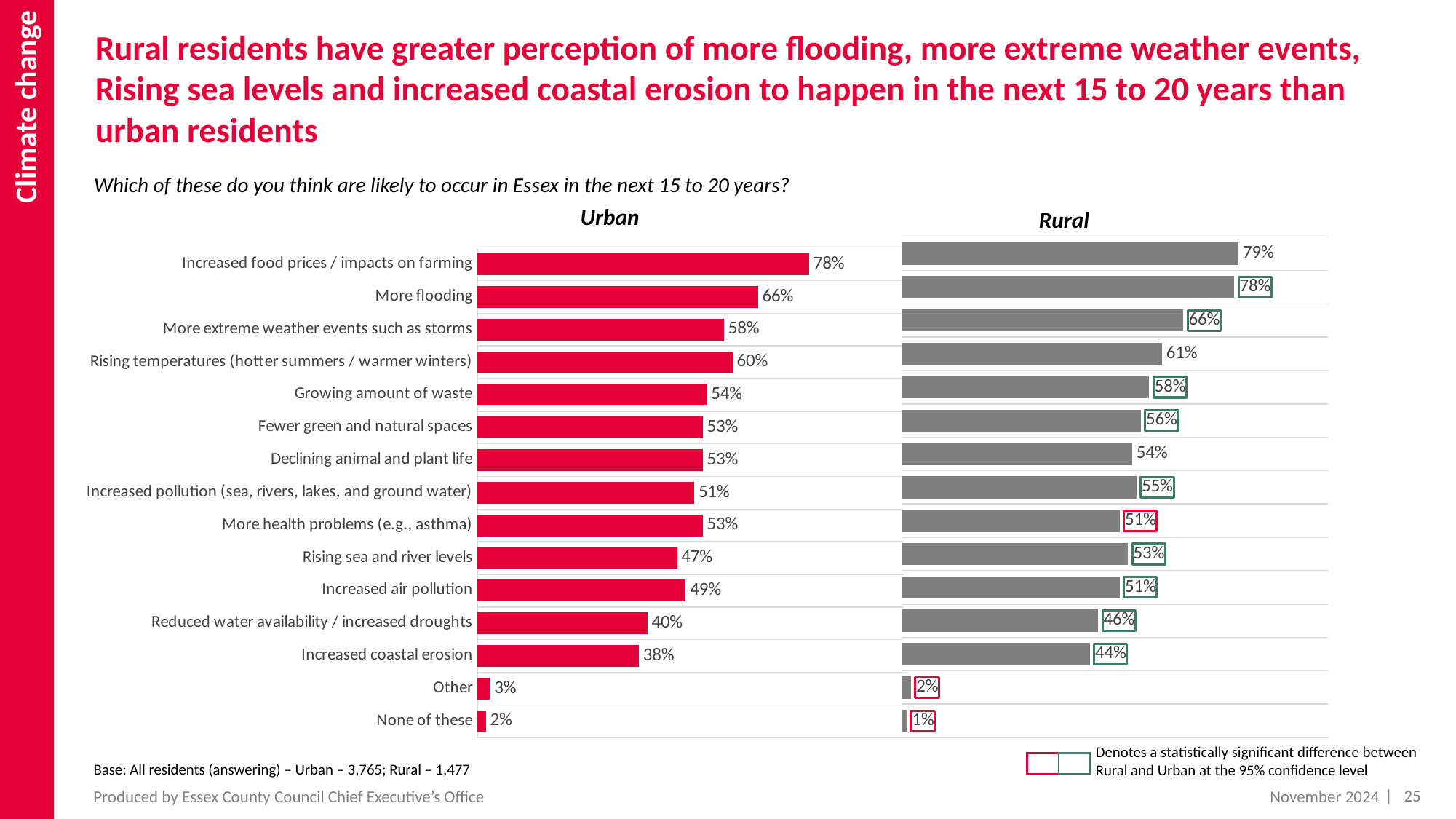
How many categories are listed in the Urban chart? 15 In the Rural chart, what is the value for 'Rising sea and river levels'? 53% What is the difference between the Rural and Urban values for 'More flooding'? 12 percentage points In the Urban chart, what percentage of respondents selected 'More flooding'? 66% What type of chart is used to show the Urban results? Bar chart For 'Increased coastal erosion', which is larger: the Urban value or the Rural value? Rural What colour are the bars in the Rural chart? Grey In the Urban chart, which category has the highest value? Increased food prices / impacts on farming In the Rural chart, which category has the lowest value? None of these For 'More health problems (e.g., asthma)', which is larger: the Urban value or the Rural value? Urban In the Rural chart, what percentage of respondents selected 'Increased coastal erosion'? 44% What is the difference between the Urban values for 'Increased food prices / impacts on farming' and 'Increased coastal erosion'? 40 percentage points